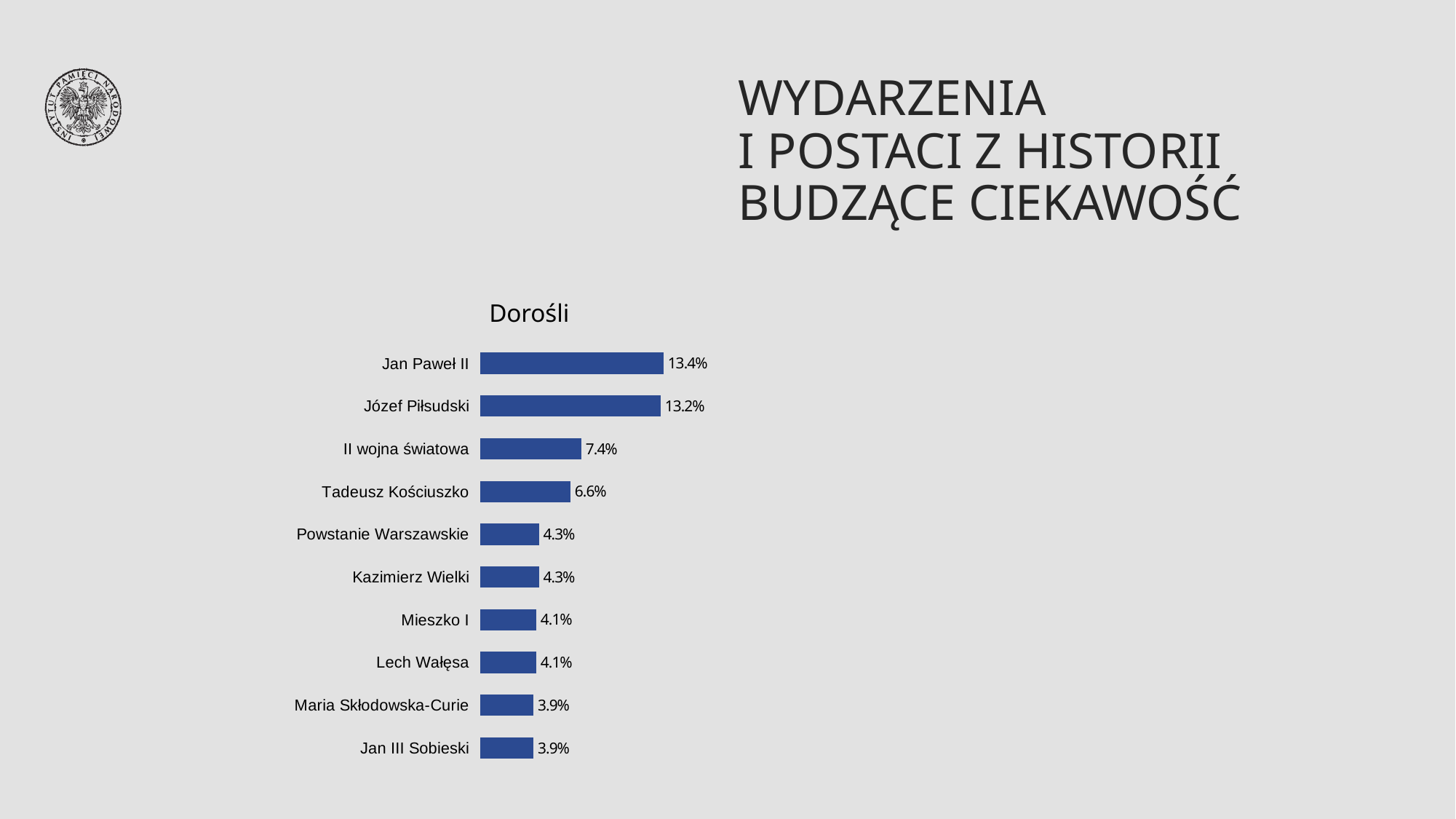
What is the difference between the values for Jan Paweł II and Józef Piłsudski? 0.2% What is the value for Tadeusz Kościuszko? 6.6% What is the title of the chart? Dorośli Which is larger, the value for II wojna światowa or the value for Powstanie Warszawskie? II wojna światowa What is the value for Lech Wałęsa? 4.1% What is the value for II wojna światowa? 7.4% What kind of chart is shown on the slide? Bar chart What is the value for Maria Skłodowska-Curie? 3.9% What is the value for Jan Paweł II? 13.4% Which category has the highest value? Jan Paweł II What is the difference between the values for II wojna światowa and Tadeusz Kościuszko? 0.8% How many categories are shown in the chart? 10